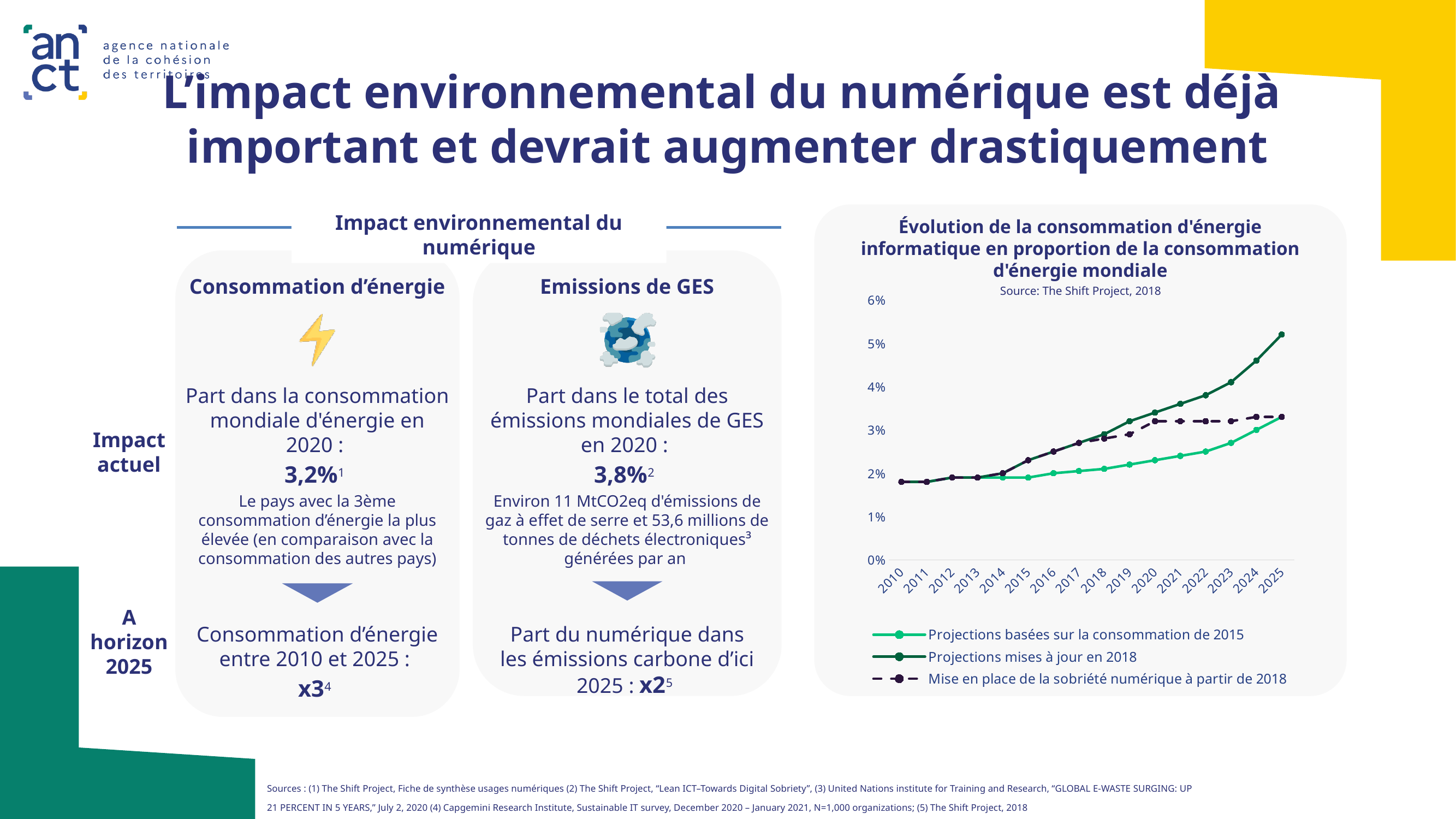
Is the 2010 value for 'Projections mises à jour en 2018' greater or less than 2%? less Which series reaches the highest value in 2025? Projections mises à jour en 2018 How many years are shown on the x axis of the chart? 16 What source is cited under the chart title? The Shift Project, 2018 In 2025, which series has the higher value: 'Projections mises à jour en 2018' or 'Projections basées sur la consommation de 2015'? Projections mises à jour en 2018 Is the 2025 value for 'Projections mises à jour en 2018' greater or less than 5%? greater What kind of chart is shown on the right side of the slide? line chart Is the 2025 value for 'Mise en place de la sobriété numérique à partir de 2018' greater or less than 3%? greater Do the values of the series 'Projections mises à jour en 2018' rise or fall from 2010 to 2025? rise How many series does the legend of the chart list? 3 In 2022, which series has the higher value: 'Projections mises à jour en 2018' or 'Mise en place de la sobriété numérique à partir de 2018'? Projections mises à jour en 2018